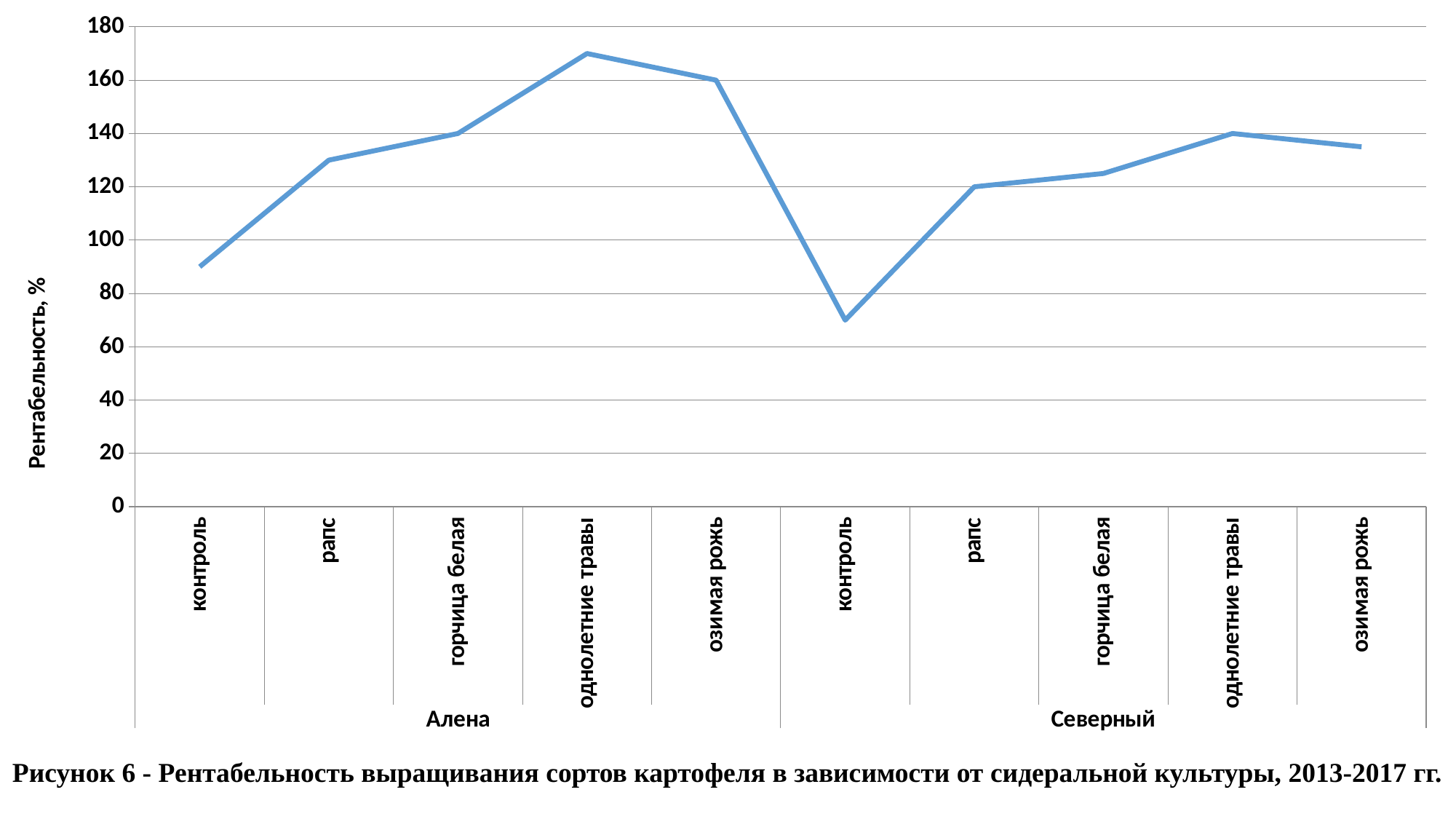
Is the value for контроль in the Северный group greater or less than 80? less What kind of chart is shown on the slide? line chart Is the value for контроль in the Алена group greater or less than 100? less What is the value for горчица белая in the Алена group? 140 What is the value for рапс in the Северный group? 120 Which category has the highest value on the chart? однолетние травы (Алена) Which category has the lowest value on the chart? контроль (Северный) How many data points are plotted on the line? 10 What is the value for озимая рожь in the Алена group? 160 What is the label of the vertical axis? Рентабельность, % Is the value for однолетние травы in the Алена group greater or less than 160? greater Which is larger: the value for рапс in the Алена group or the value for рапс in the Северный group? рапс in the Алена group